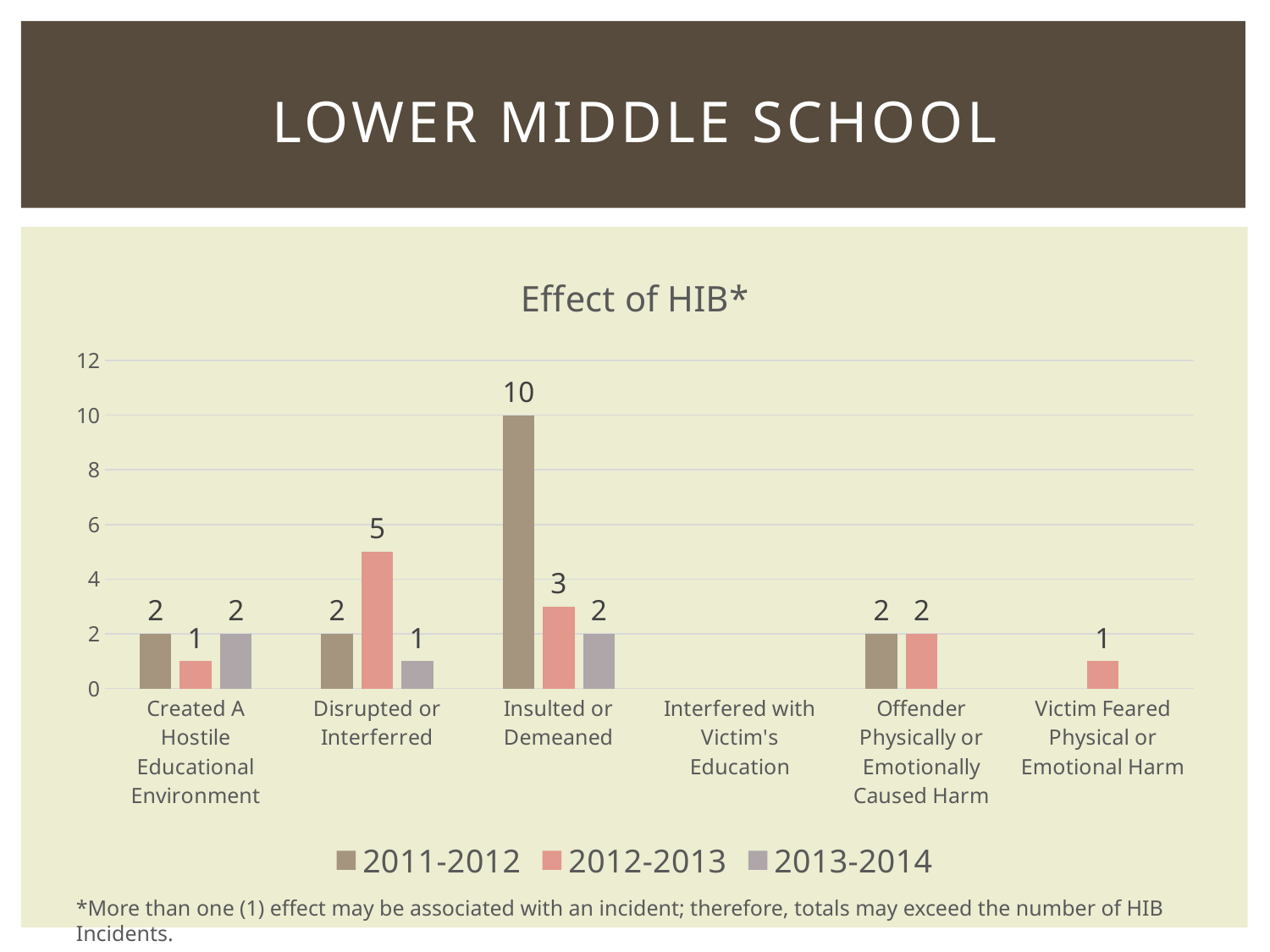
What is the value for 2012-2013 in the Victim Feared Physical or Emotional Harm category? 1 Which category has the highest value for the 2012-2013 series? Disrupted or Interferred What is the value for 2011-2012 in the Insulted or Demeaned category? 10 How many series does the legend list? 3 What is the value for 2013-2014 in the Created A Hostile Educational Environment category? 2 Which category has the highest value for the 2011-2012 series? Insulted or Demeaned Which is larger in the Disrupted or Interferred category: the 2012-2013 value or the 2013-2014 value? 2012-2013 How many categories are shown on the x axis? 6 What is the title of the chart? Effect of HIB* What is the difference between the 2011-2012 and 2012-2013 values in the Insulted or Demeaned category? 7 What is the value for 2012-2013 in the Disrupted or Interferred category? 5 What kind of chart is shown on the slide? Bar chart